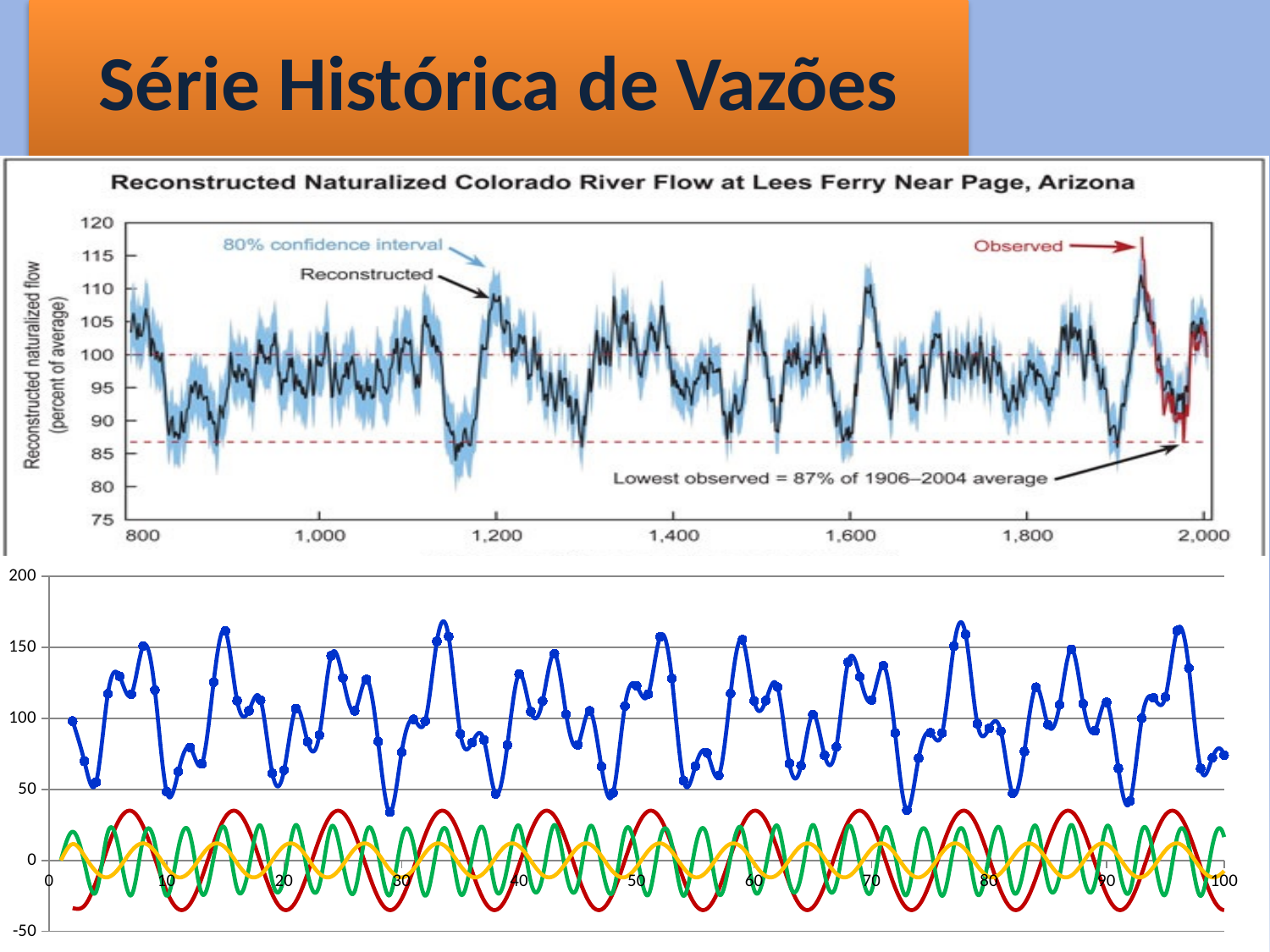
In the top chart, what is the highest value shown on the y axis? 120 What kind of chart is the bottom chart? line chart In the top chart, what is the last year label on the x axis? 2,000 In the top chart, what confidence interval is shown by the shaded band? 80% confidence interval What is the title of the top chart? Reconstructed Naturalized Colorado River Flow at Lees Ferry Near Page, Arizona In the top chart, what is the lowest observed flow as a percent of the 1906–2004 average? 87% How many lines are plotted in the bottom chart? 4 What kind of chart is the top chart? line chart In the bottom chart, are the peaks of the red line greater or less than 50? less In the bottom chart, is the value of the blue line at x = 0 greater or less than 50? greater In the top chart, what is the first year label on the x axis? 800